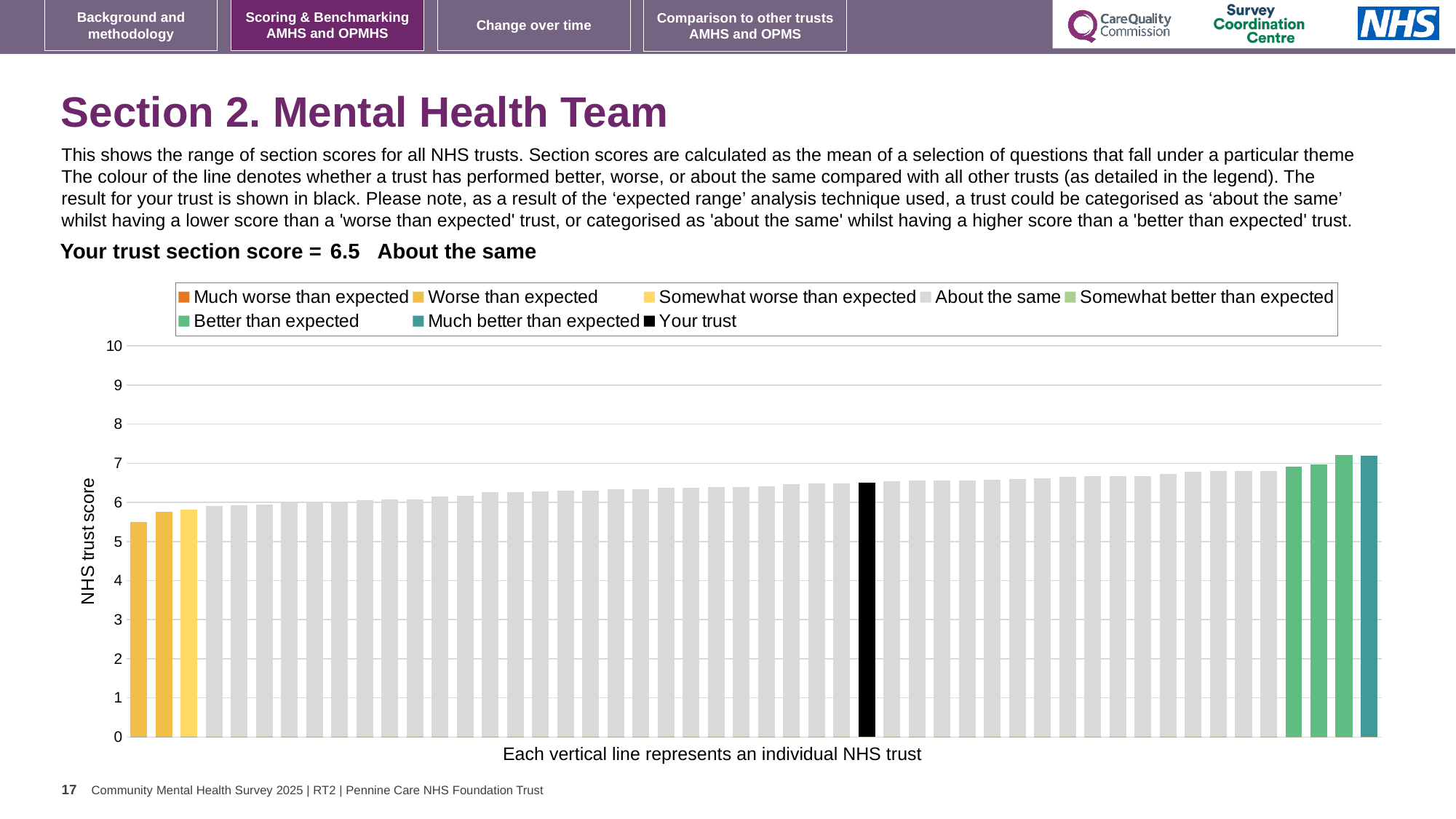
How many entries does the chart legend list? 8 What colour is the bar representing your trust in the chart? Black What kind of chart is shown on the slide? Bar chart Is the value of the lowest bar in the chart greater or less than 6? less Is the value of the tallest bar in the chart greater or less than 8? less Is the value of the lowest bar in the chart greater or less than 5? greater What is the title of the vertical axis of the chart? NHS trust score What is the section score for your trust shown on the slide? 6.5 Do the bar values rise or fall from left to right along the x axis? Rise Which legend category does the lowest bar in the chart belong to? Worse than expected Which legend category does the tallest bar in the chart belong to? Better than expected